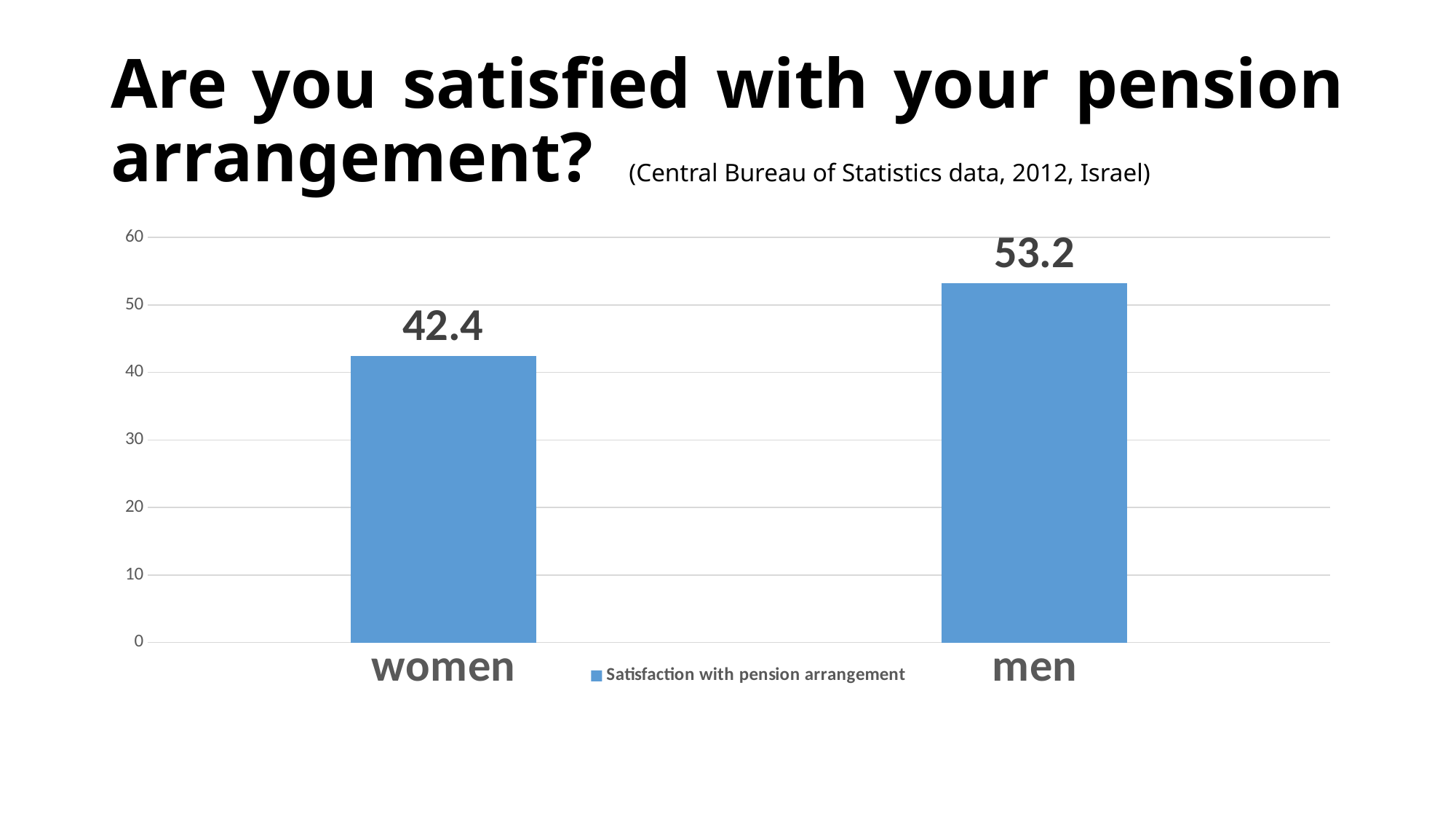
What kind of chart is shown on the slide? bar chart What is the name of the series shown in the legend? Satisfaction with pension arrangement What is the value for women? 42.4 How many categories are shown on the x axis? 2 Is the value for women greater or less than 50? less What is the value for men? 53.2 Which is larger, the value for women or the value for men? men How many series does the legend list? 1 What is the difference between the values for men and women? 10.8 Which category has the lowest value? women Is the value for men greater or less than 50? greater Which category has the highest value? men